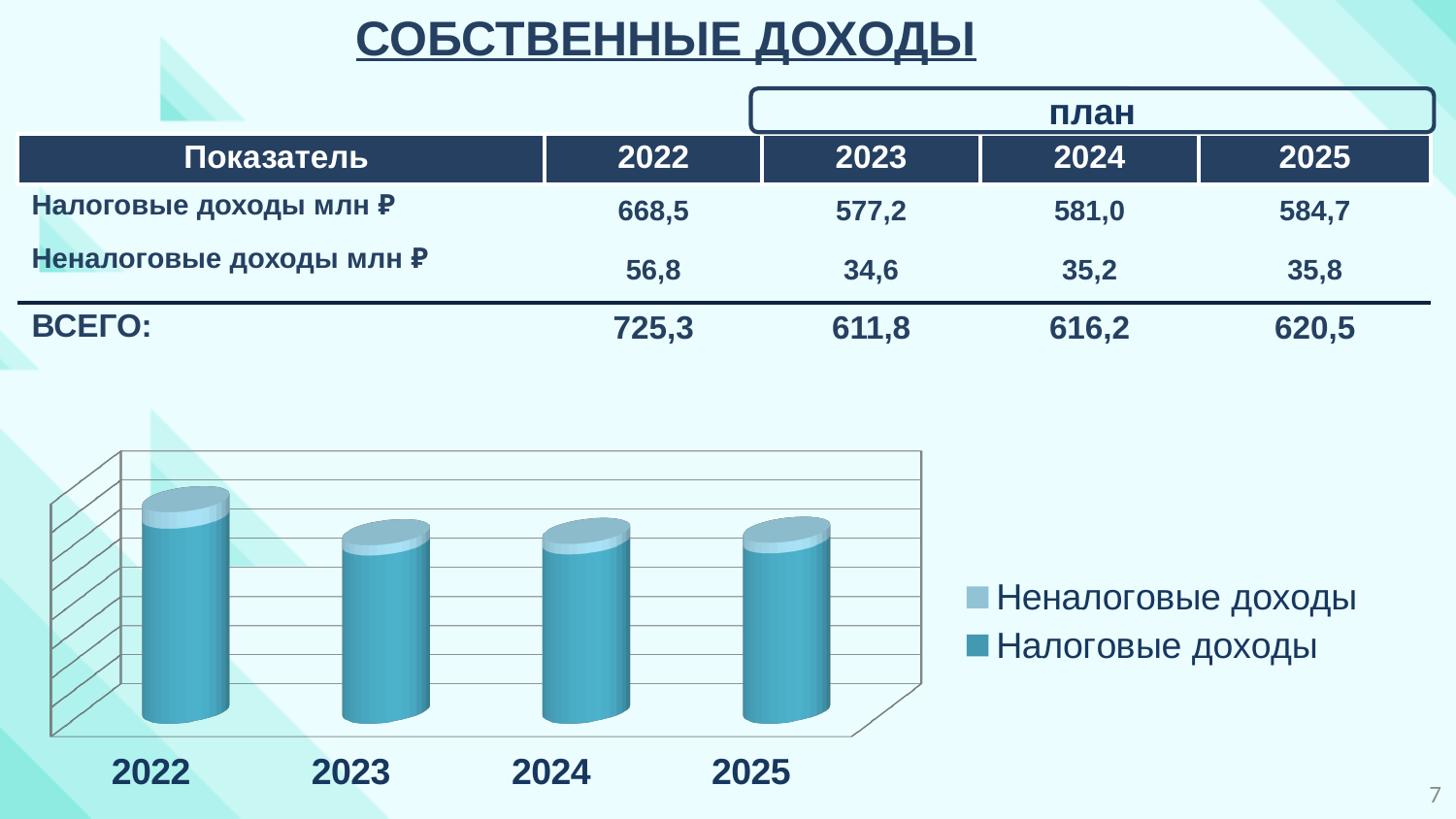
What is the value of Неналоговые доходы for 2025 (млн ₽)? 35,8 Does the total height of the bars fall or rise from 2022 to 2023? fall What is the total (ВСЕГО) of the stacked bar for 2024? 616,2 How many series does the chart legend list? 2 What is the total (ВСЕГО) of the stacked bar for 2022? 725,3 What is the value of Налоговые доходы for 2022 (млн ₽)? 668,5 What is the difference between Налоговые доходы in 2022 and in 2023? 91,3 Which year has the tallest stacked bar on the chart? 2022 What kind of chart is shown on the slide? bar chart Is the stacked bar for 2022 taller or shorter than the bar for 2023? taller What are the two series named in the chart legend? Неналоговые доходы, Налоговые доходы How many years (categories) are shown on the chart's x axis? 4